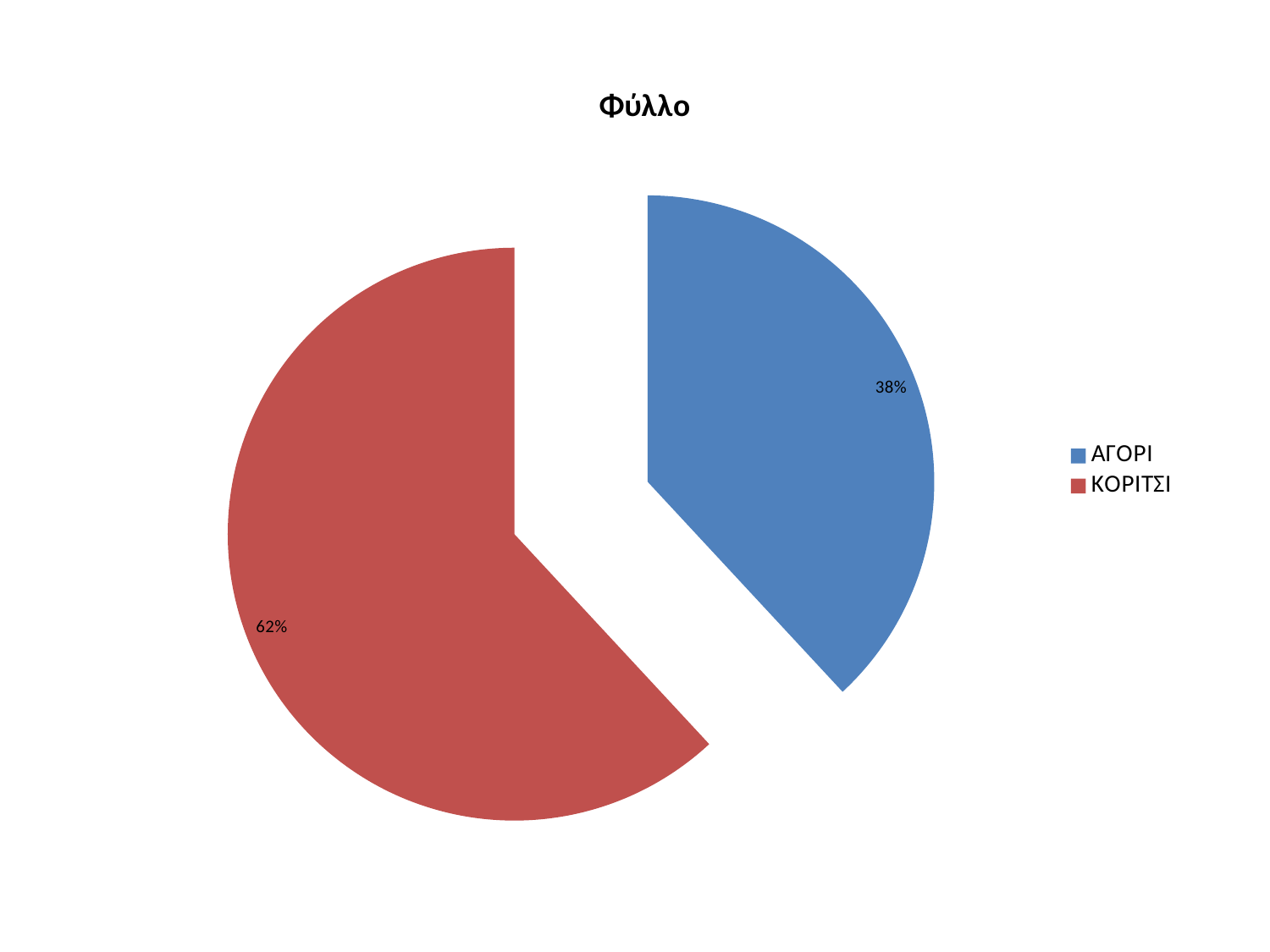
Which category has the smallest slice of the pie? ΑΓΟΡΙ Which is larger, the ΑΓΟΡΙ slice or the ΚΟΡΙΤΣΙ slice? ΚΟΡΙΤΣΙ What share of the pie does ΚΟΡΙΤΣΙ represent? 62% How many entries does the legend list? 2 Is the share for ΑΓΟΡΙ greater or less than 50%? less Which category has the largest slice of the pie? ΚΟΡΙΤΣΙ What is the difference in percentage points between the ΚΟΡΙΤΣΙ and ΑΓΟΡΙ slices? 24 What kind of chart is shown on the slide? Pie chart What colour is the ΚΟΡΙΤΣΙ slice? Red What is the title of the chart? Φύλλο What share of the pie does ΑΓΟΡΙ represent? 38% How many categories does the pie chart have? 2